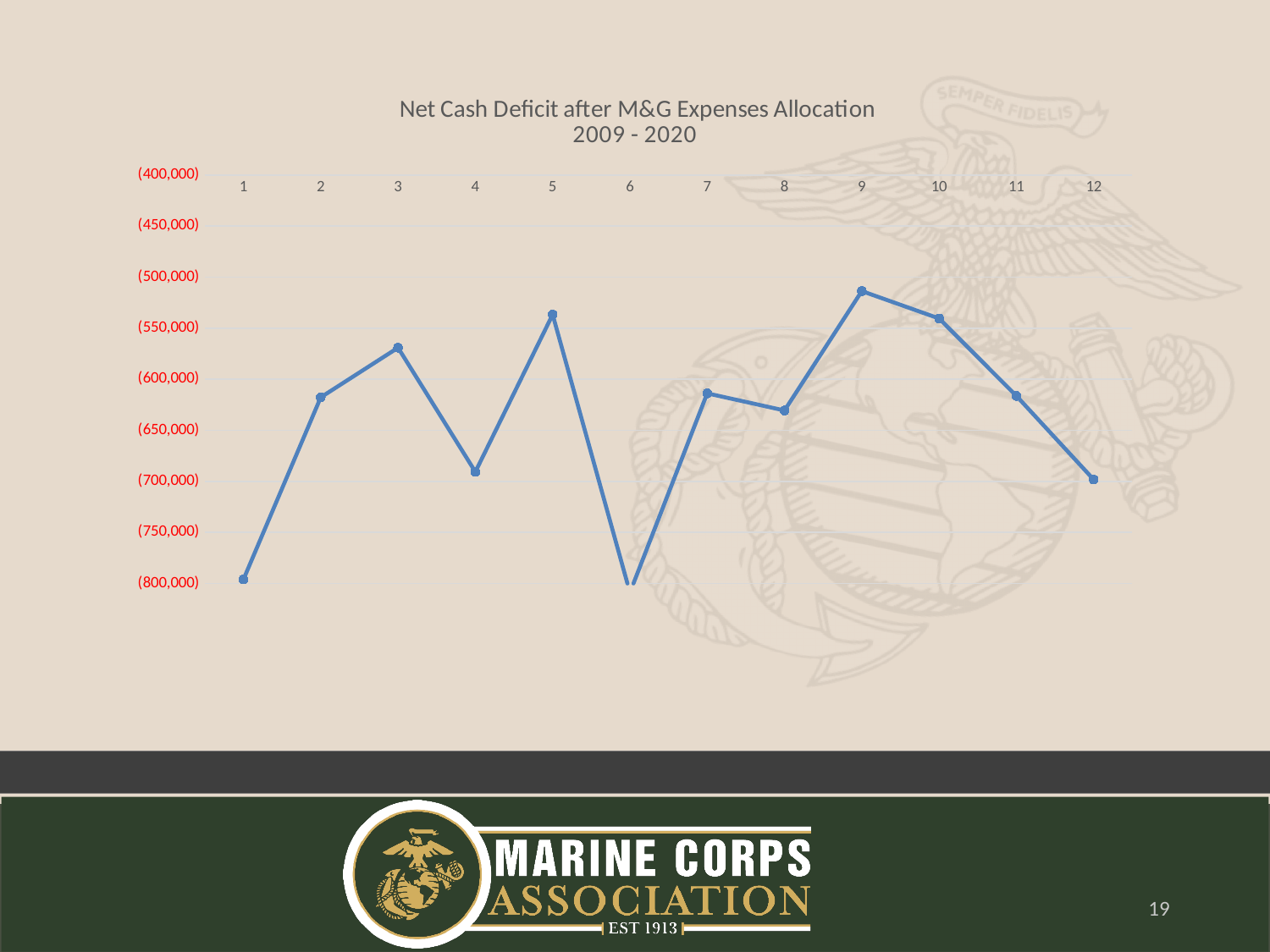
Is the value at point 12 greater or less than (650,000)? less Is the value at point 9 greater or less than (550,000)? greater Which is higher on the chart, the value at point 9 or the value at point 12? point 9 How many data points are plotted on the line? 12 What kind of chart is shown on the slide? line chart From point 9 to point 12, does the line rise or fall? fall Is the value at point 8 greater or less than (600,000)? less What is the title of the chart? Net Cash Deficit after M&G Expenses Allocation 2009 - 2020 Which is higher on the chart, the value at point 3 or the value at point 4? point 3 Which point on the x axis has the highest value (closest to the top of the chart)? 9